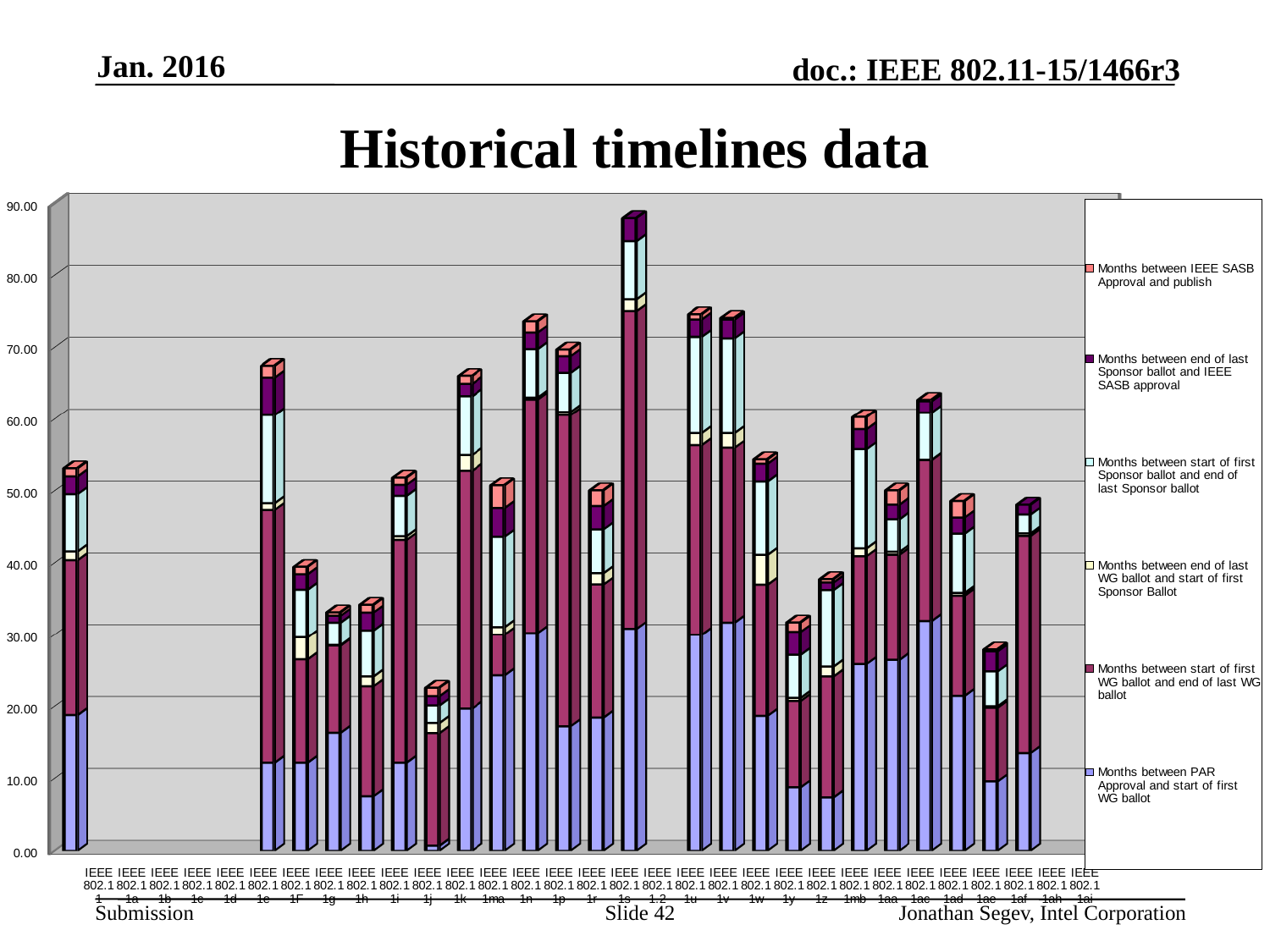
How many series does the legend list? 6 What is the title of the chart? Historical timelines data What is the highest value shown on the vertical axis? 90.00 Is the total for the first category, IEEE 802.1 1, greater or less than 60? less Which legend entry is shown at the bottom of the stack (the bottom segment of each bar)? Months between PAR Approval and start of first WG ballot Which is larger, the total for IEEE 802.1 1s or the total for IEEE 802.1 1j? IEEE 802.1 1s Which category has the tallest stacked bar? IEEE 802.1 1s Is the total for IEEE 802.1 1s greater or less than 80? greater What kind of chart is shown on the slide? Stacked bar chart